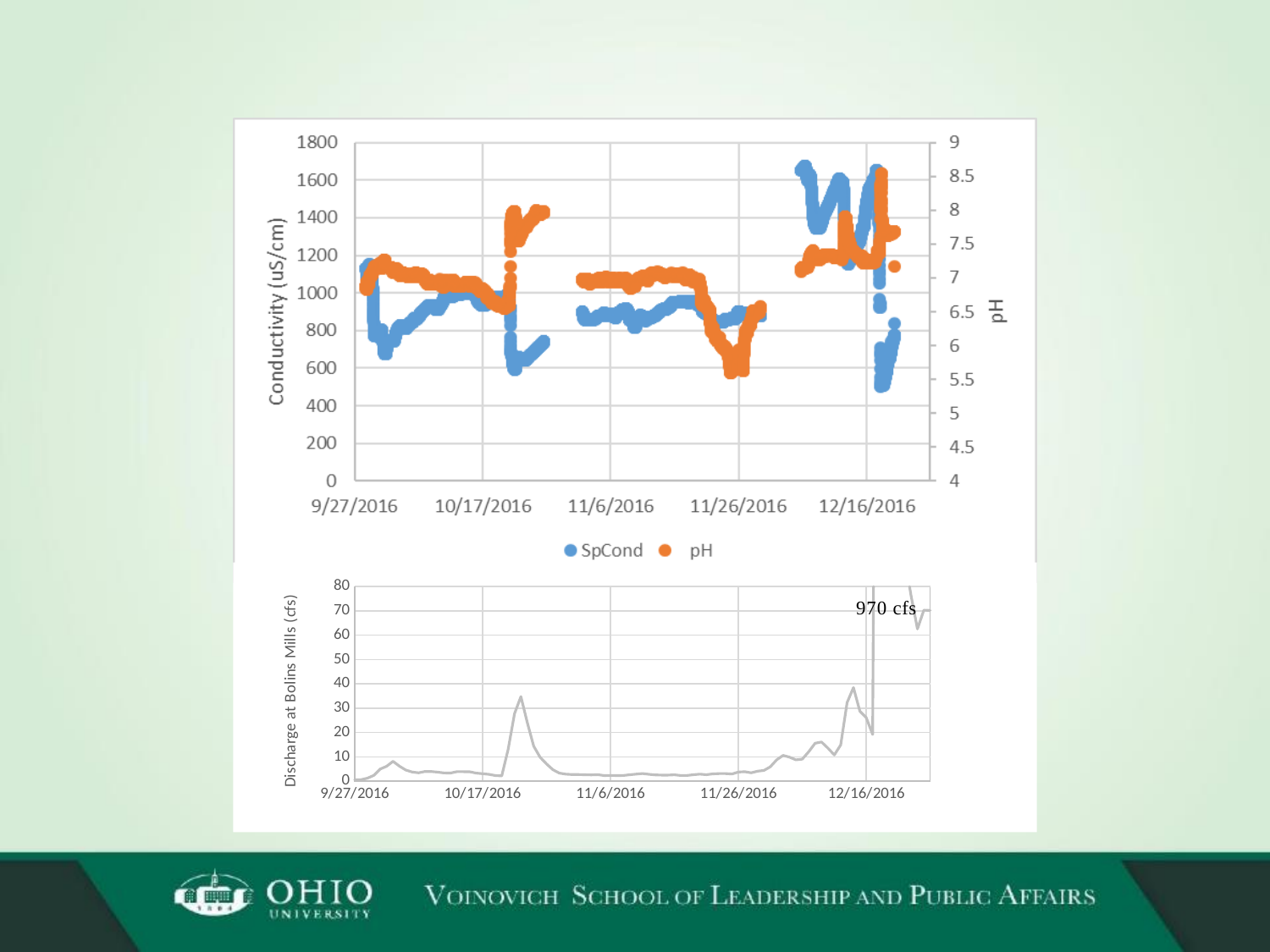
On the bottom chart, is the discharge value around 11/6/2016 greater or less than 10? less On the top chart, how many series does the legend list? 2 On the bottom chart, what peak discharge value is annotated near 12/16/2016? 970 cfs On the top chart, what is the lowest value shown on the right (pH) axis? 4 On the top chart, what is the maximum value shown on the left vertical axis? 1800 On the top chart, is the pH value around 11/22/2016 greater or less than 6.5? less On the top chart, what are the two series named in the legend? SpCond and pH What kind of chart is the bottom chart? line chart On the top chart, what is the label of the left vertical axis? Conductivity (uS/cm) On the top chart, is the SpCond value just after 12/6/2016 greater or less than 1400? greater On the bottom chart, what is the label of the vertical axis? Discharge at Bolins Mills (cfs)